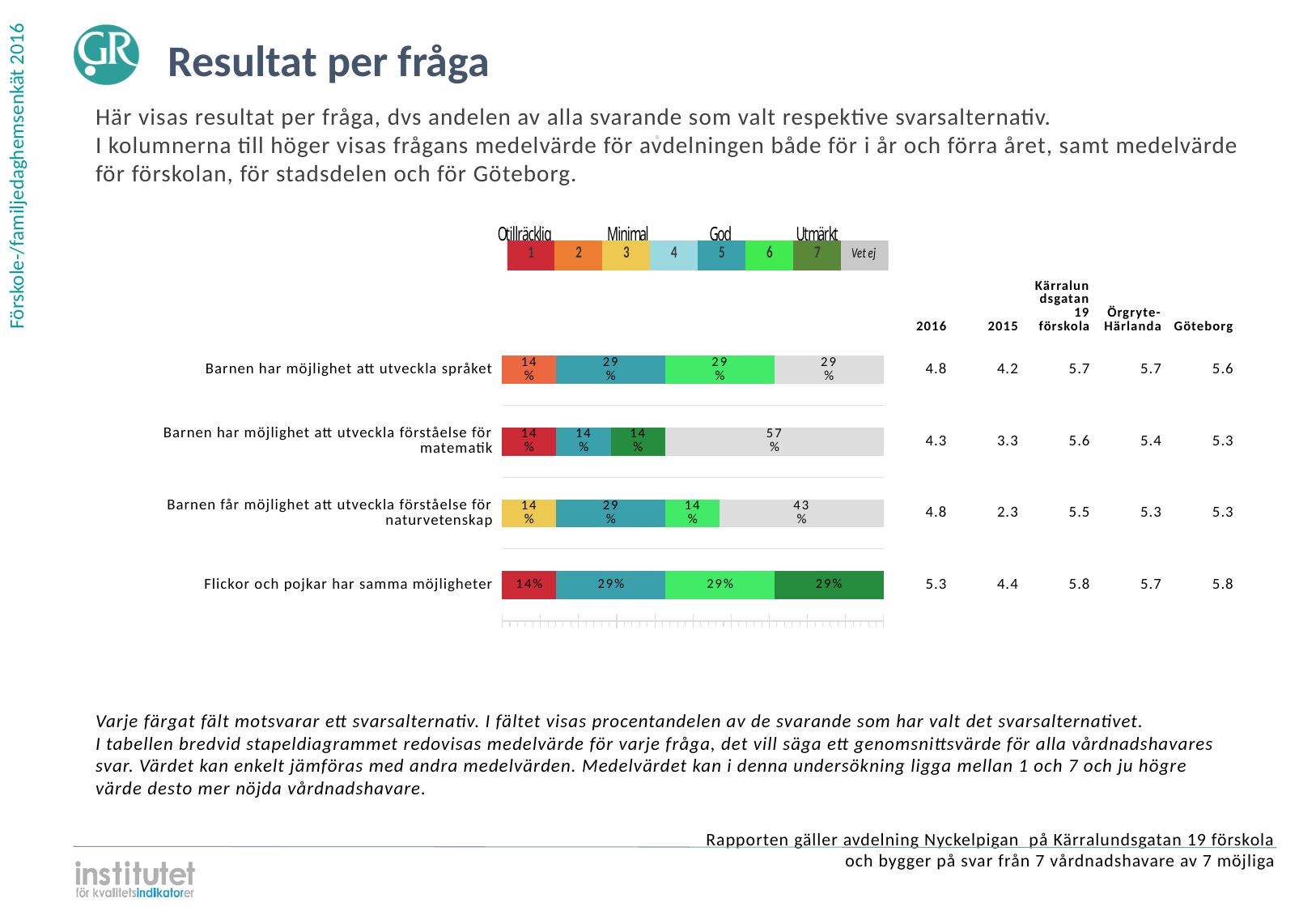
What percentage of respondents chose option 7 (dark green) for 'Flickor och pojkar har samma möjligheter'? 29% How many questions (categories) are plotted in the bar chart? 4 Which question has no 'Vet ej' (grey) segment in its bar? Flickor och pojkar har samma möjligheter What percentage of respondents answered 'Vet ej' for 'Barnen har möjlighet att utveckla förståelse för matematik'? 57% What percentage of respondents chose option 1 (red) for 'Flickor och pojkar har samma möjligheter'? 14% What is the difference between the 'Vet ej' share for the matematik question (57%) and the naturvetenskap question (43%)? 14% What percentage of respondents answered 'Vet ej' for 'Barnen får möjlighet att utveckla förståelse för naturvetenskap'? 43% What kind of chart is shown on the slide? Stacked bar chart Which is larger for 'Barnen har möjlighet att utveckla språket': the 2016 mean or the 2015 mean? 2016 (4.8) What is the 2016 mean value shown for 'Flickor och pojkar har samma möjligheter'? 5.3 Which question has the largest 'Vet ej' (grey) share? Barnen har möjlighet att utveckla förståelse för matematik How many response options does the legend above the chart list? 8